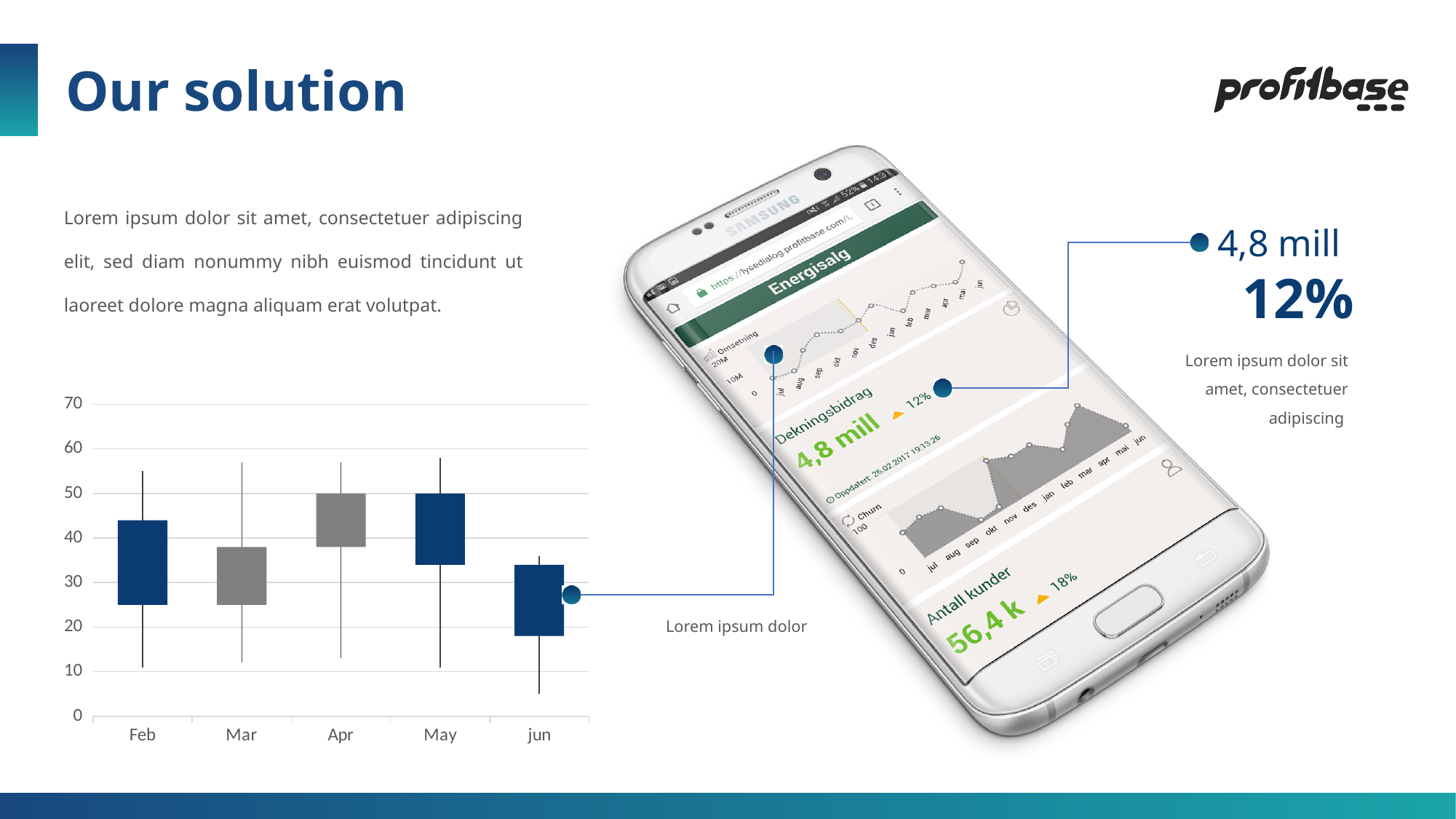
Is the bottom of the jun box greater or less than 20? less How many categories are shown on the x axis of the chart? 5 Is the lower whisker of jun greater or less than 10? less Is the bottom of the May box greater or less than 30? greater Which category has the lowest whisker (lowest line end) on the chart? jun Which category's box reaches the lowest value on the chart? jun What is the highest value shown on the chart's y axis? 70 What kind of chart is shown on the left of the slide? candlestick (stock) chart How many of the boxes on the chart are coloured gray? 2